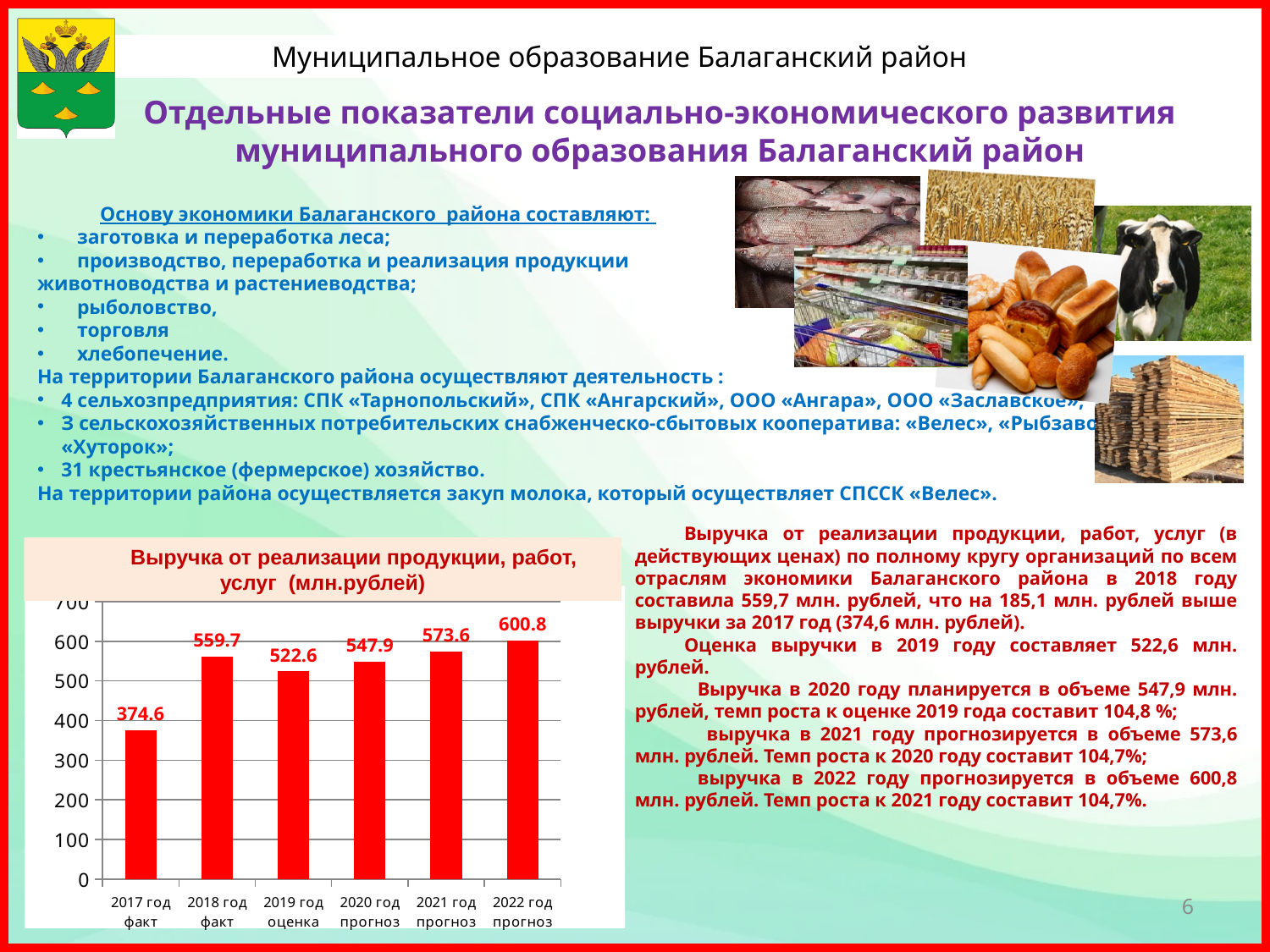
How many categories are shown on the x axis of the revenue chart? 6 What is the value for 2019 год оценка in the revenue chart? 522.6 Which is larger in the revenue chart: the value for 2018 год факт or 2019 год оценка? 2018 год факт What is the title of the chart on the slide? Выручка от реализации продукции, работ, услуг (млн.рублей) Which category has the highest value in the revenue chart? 2022 год прогноз Which category has the lowest value in the revenue chart? 2017 год факт What is the value for 2017 год факт in the chart 'Выручка от реализации продукции, работ, услуг (млн.рублей)'? 374.6 What kind of chart is used to show revenue from sales of products, works and services? bar chart Is the value for 2020 год прогноз in the revenue chart greater or less than 500? greater What is the difference between the values for 2018 год факт and 2017 год факт in the revenue chart? 185.1 What is the difference between the values for 2022 год прогноз and 2021 год прогноз in the revenue chart? 27.2 What is the value for 2022 год прогноз in the revenue chart? 600.8